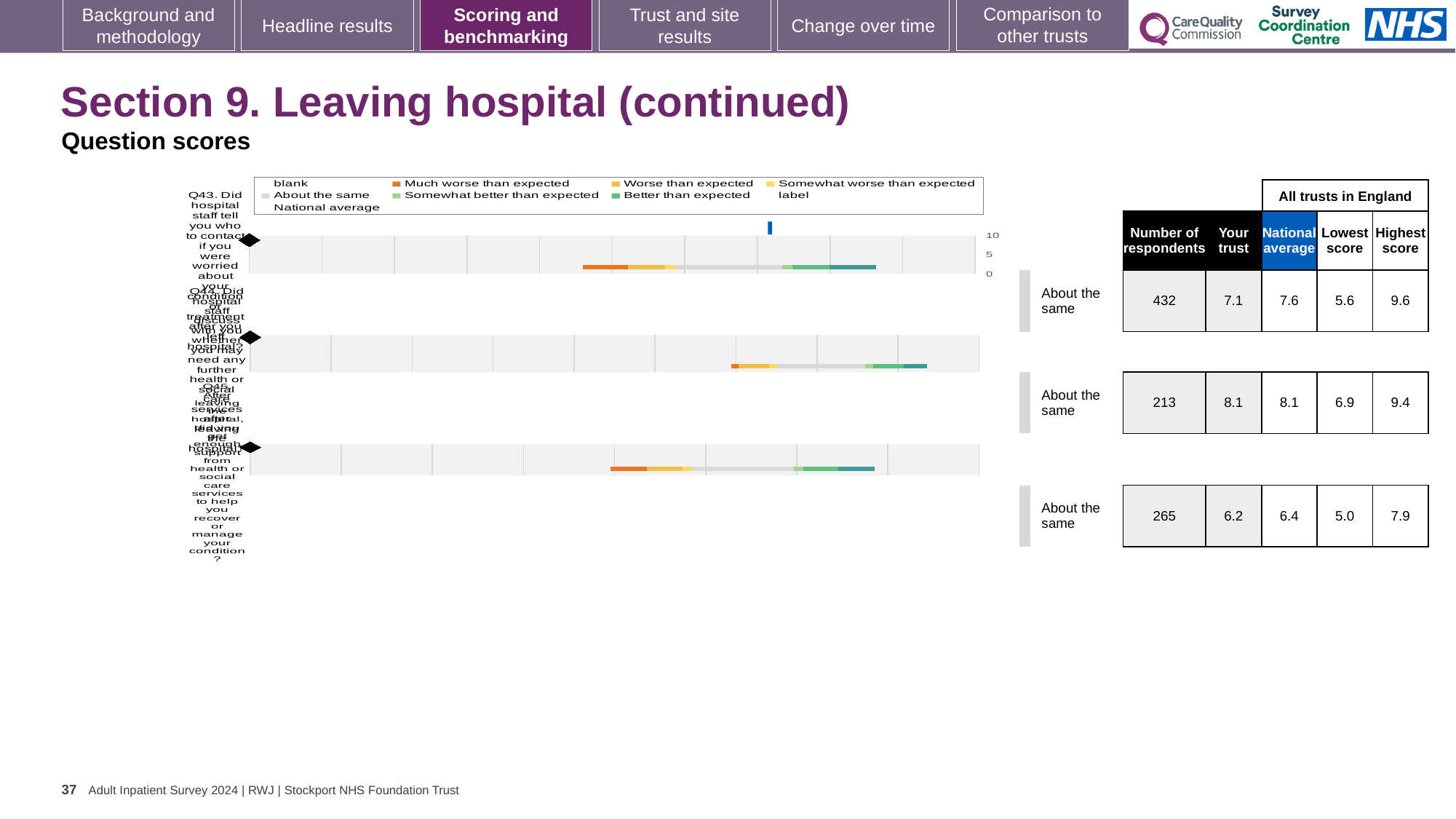
Which question row has the lowest 'Your trust' score? the third row (6.2) Is the 'Your trust' score for the third question row larger or smaller than its national average? smaller What is the 'Your trust' score for the first question row (Q43, 432 respondents)? 7.1 What is the national average for the first question row (Q43)? 7.6 What kind of chart is shown on the slide? bar chart What is the lowest score among all trusts in England for the third question row (265 respondents)? 5.0 How many questions (bars) are plotted in the chart? 3 What is the difference between the national average and the 'Your trust' score for the first question row? 0.5 What is the maximum value shown on the chart's score axis? 10 Which question row has the highest 'Your trust' score? the second row (8.1) What benchmark category is shown for each of the three question rows? About the same What is the highest score among all trusts in England for the second question row (213 respondents)? 9.4